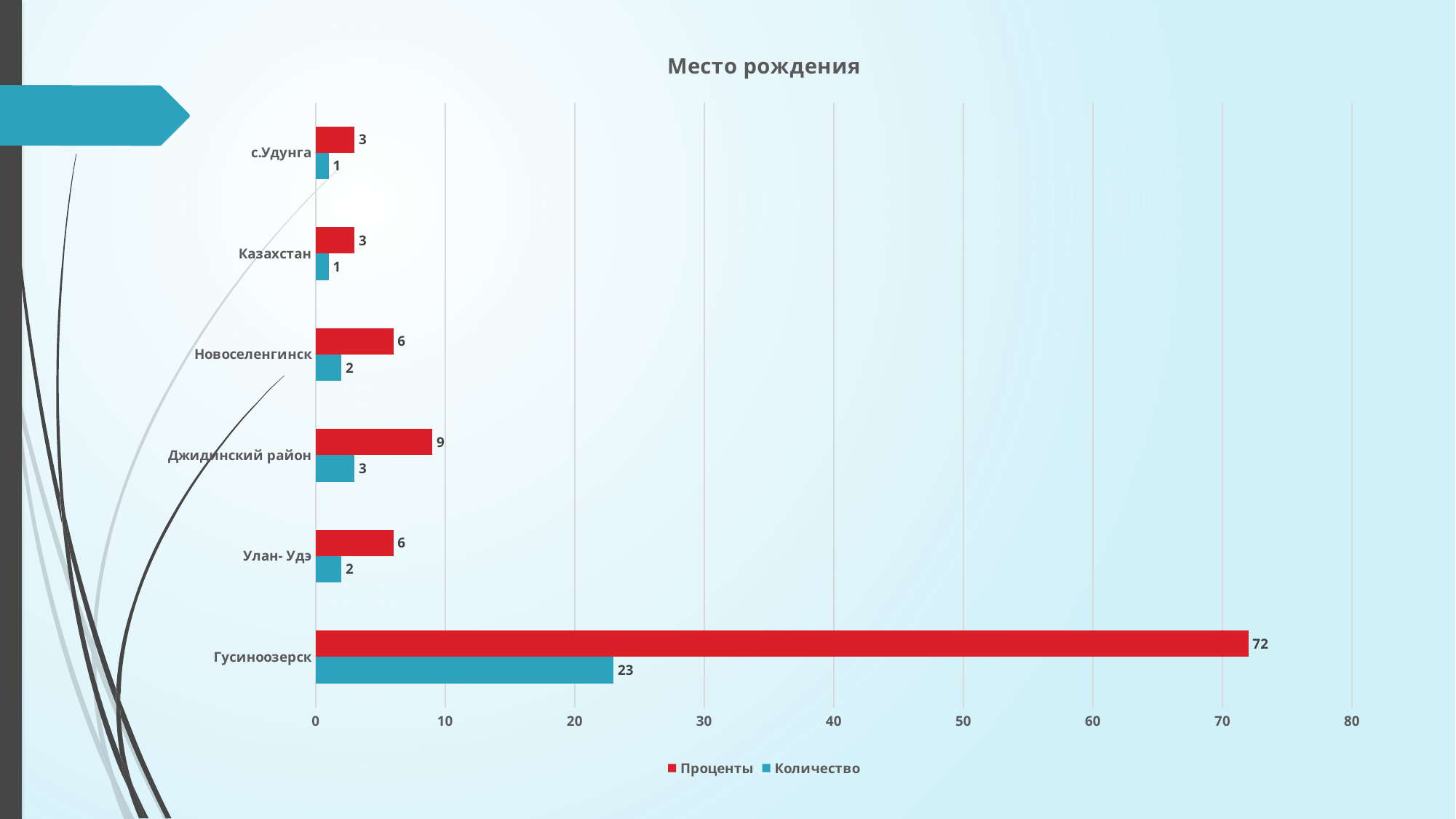
How many categories are shown on the chart? 6 Which category has the highest Проценты value? Гусиноозерск Is the Проценты value for Гусиноозерск greater or less than 70? greater What is the Количество value for Джидинский район? 3 Which is larger, the Количество value for Джидинский район or for Улан- Удэ? Джидинский район How many series does the legend list? 2 Which category has the highest Количество value? Гусиноозерск What type of chart is shown on the slide? bar chart What is the Проценты value for Гусиноозерск? 72 What is the difference between the Проценты values for Гусиноозерск and Джидинский район? 63 What is the Количество value for Гусиноозерск? 23 What is the Проценты value for Новоселенгинск? 6